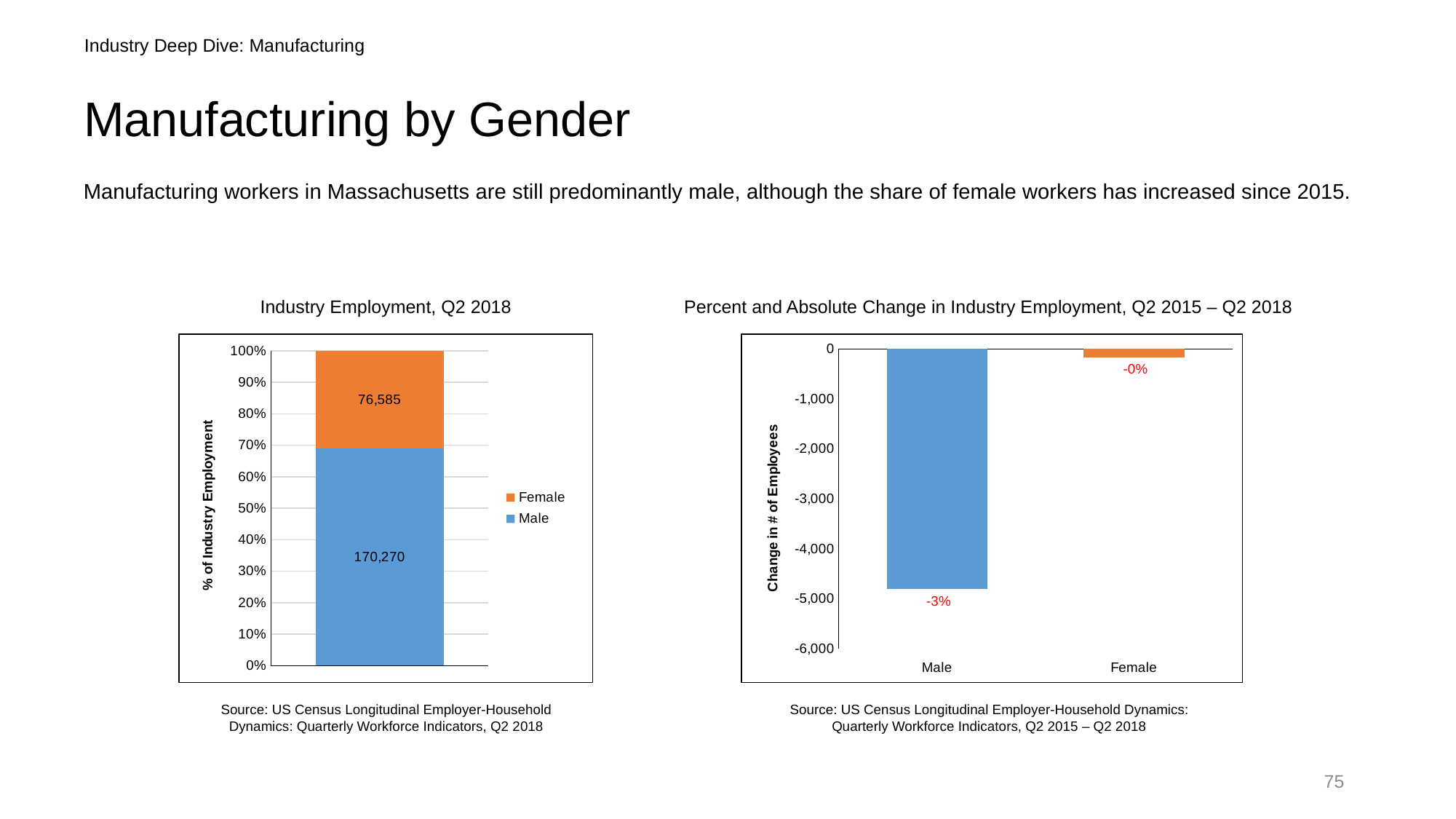
What kind of chart is 'Industry Employment, Q2 2018'? Stacked bar chart In the 'Industry Employment, Q2 2018' chart, which is larger, Male or Female? Male In the 'Percent and Absolute Change in Industry Employment, Q2 2015 – Q2 2018' chart, what percent change is labelled for Female? -0% In the 'Industry Employment, Q2 2018' chart, what is the total of the stacked bar? 246,855 In the 'Percent and Absolute Change in Industry Employment, Q2 2015 – Q2 2018' chart, what percent change is labelled for Male? -3% In the 'Percent and Absolute Change in Industry Employment, Q2 2015 – Q2 2018' chart, which category has the lowest change in number of employees? Male In the 'Industry Employment, Q2 2018' chart, how many series does the legend list? 2 In the 'Industry Employment, Q2 2018' chart, what is the difference between the Male and Female values? 93,685 In the 'Industry Employment, Q2 2018' chart, what is the value for Female? 76,585 In the 'Industry Employment, Q2 2018' chart, what is the value for Male? 170,270 In the 'Percent and Absolute Change in Industry Employment, Q2 2015 – Q2 2018' chart, how many categories are shown on the x axis? 2 In the 'Percent and Absolute Change in Industry Employment, Q2 2015 – Q2 2018' chart, is the change in number of employees for Male greater or less than -4,000? less